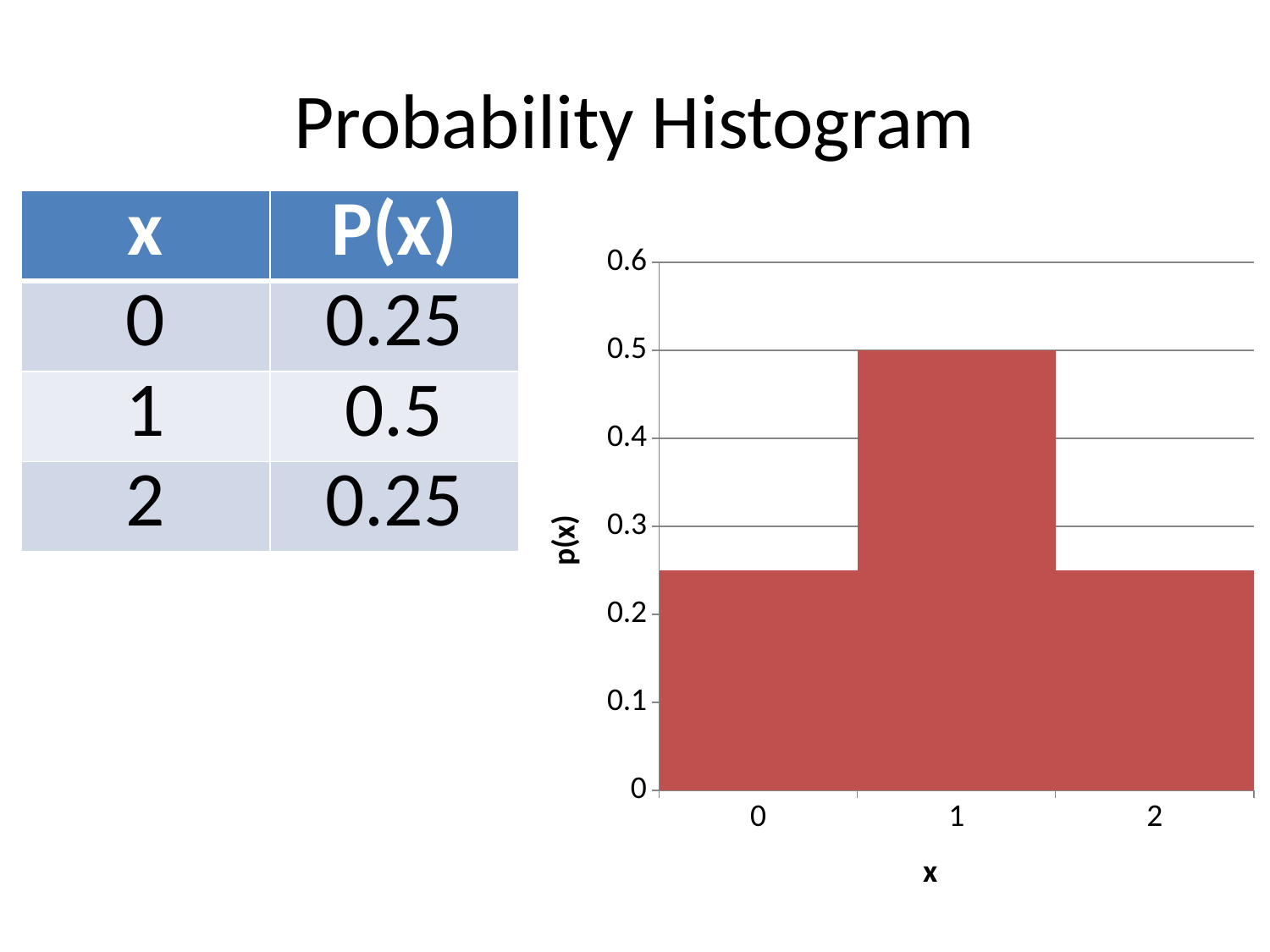
What is the highest tick value shown on the vertical axis? 0.6 What is the value of p(x) for x = 1 in the chart? 0.5 What kind of chart is shown on the slide? bar chart What is the value of p(x) for x = 0 in the chart? 0.25 Which is larger, the bar for x = 1 or the bar for x = 2? x = 1 What is the label of the vertical axis of the chart? p(x) Which value of x has the highest bar in the chart? 1 Is the value for x = 0 greater or less than 0.3? less How many bars are shown in the chart? 3 What is the value of p(x) for x = 2 in the chart? 0.25 What is the difference between p(x) at x = 1 and p(x) at x = 0? 0.25 Is the value for x = 1 greater or less than 0.4? greater